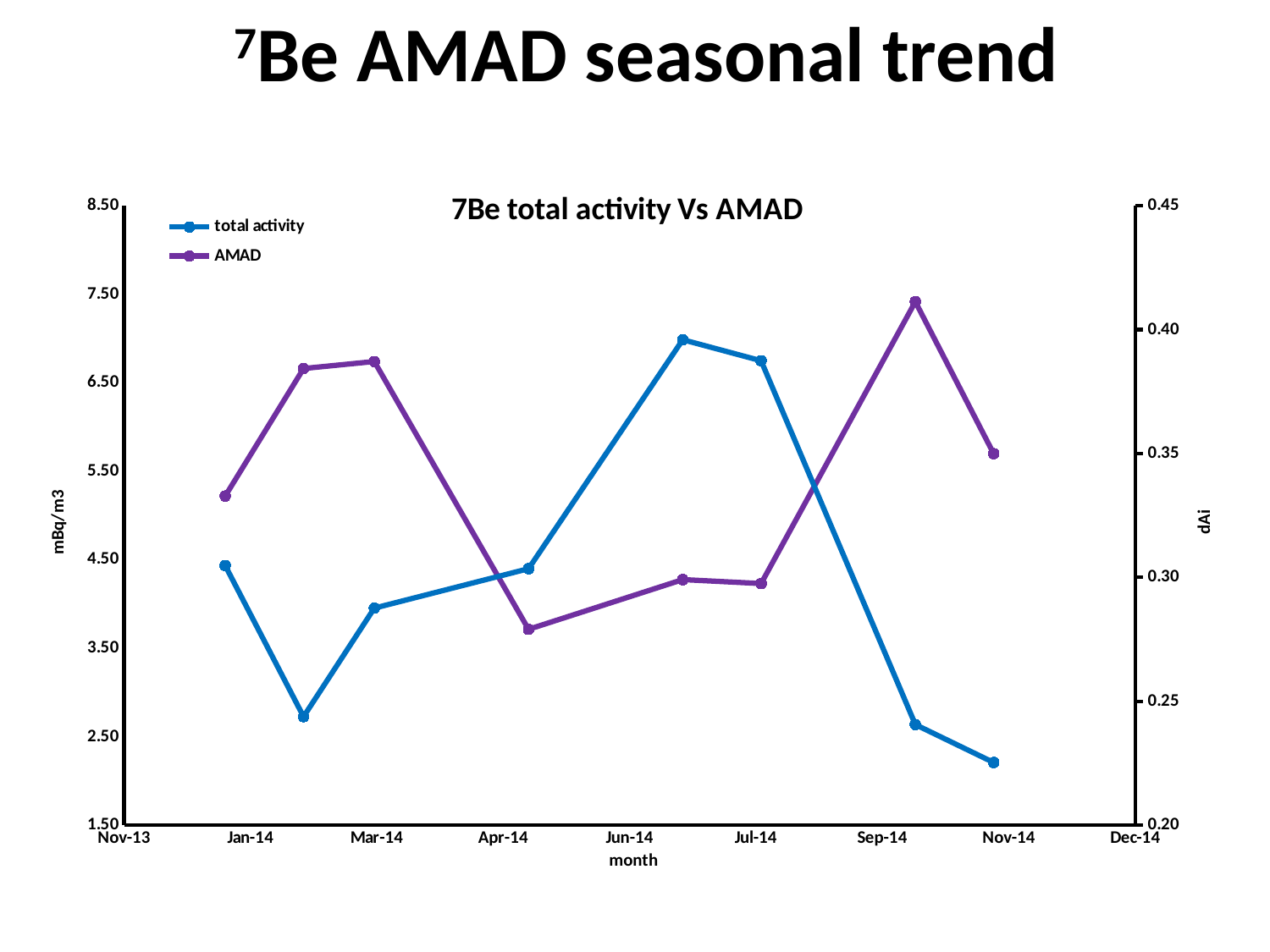
Is the highest plotted value of the AMAD series greater or less than 0.40 on the right axis? greater Is the second plotted value of the total activity series greater or less than 3.50? less What is the title printed inside the chart area? 7Be total activity Vs AMAD Comparing the first and last plotted points, does the total activity series rise or fall over the period shown? fall Is the lowest plotted value of the AMAD series greater or less than 0.30 on the right axis? less What kind of chart is shown on the slide? line chart How many series does the legend list? 2 Which is larger for the total activity series: the first plotted value or the second plotted value? the first plotted value What is the label on the left vertical axis? mBq/m3 How many data points are plotted for the total activity series? 8